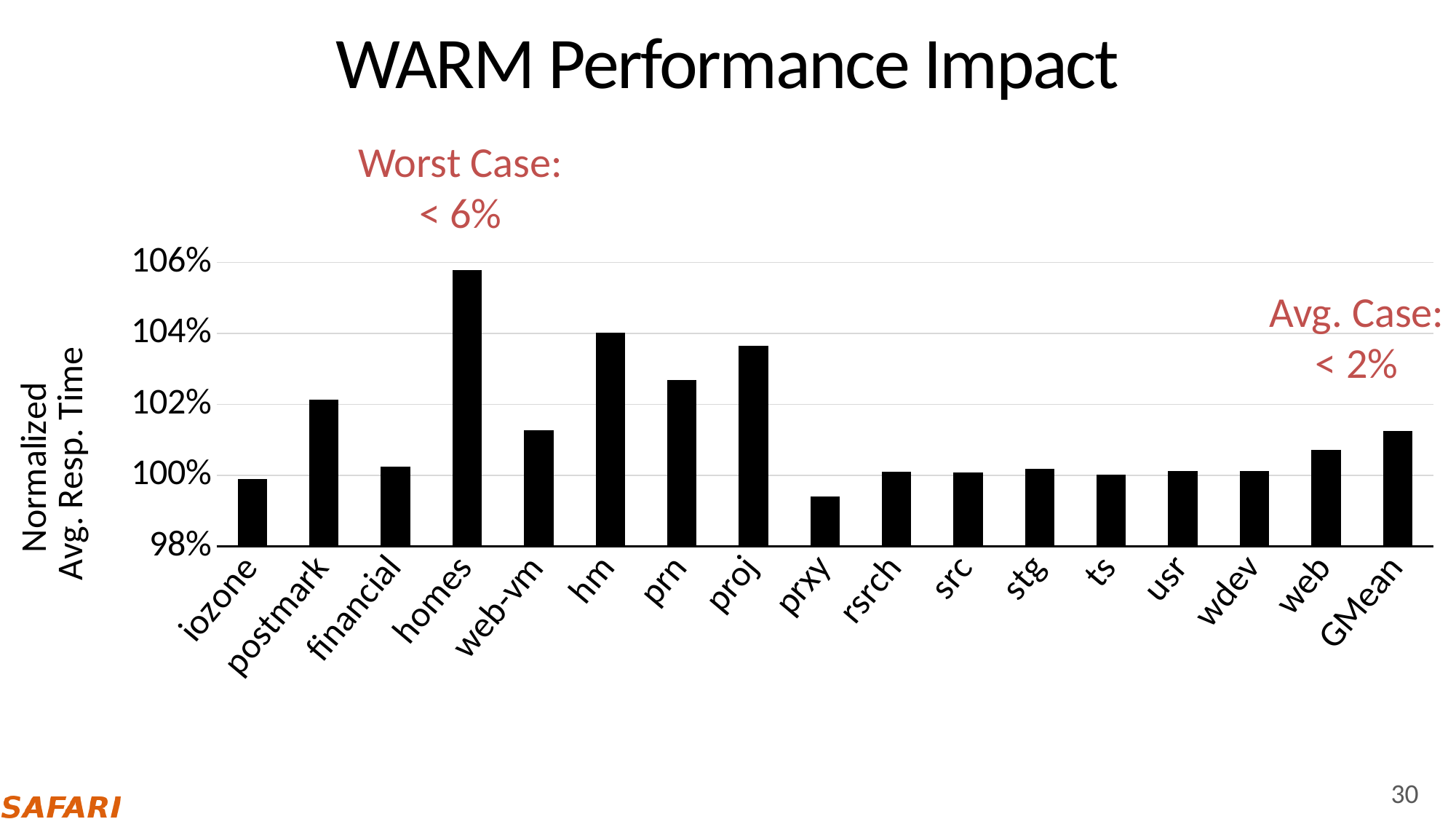
Which has the larger value, postmark or web-vm? postmark What is the title of the slide's chart? WARM Performance Impact Which has the larger value, homes or hm? homes Is the value for GMean greater or less than 100%? greater Is the value for proj greater or less than 102%? greater Which category has the lowest normalized average response time? prxy What is the label on the y axis? Normalized Avg. Resp. Time What kind of chart is shown on the slide? bar chart Which category has the highest normalized average response time? homes Is the value for homes greater or less than 104%? greater How many categories are plotted along the x axis? 17